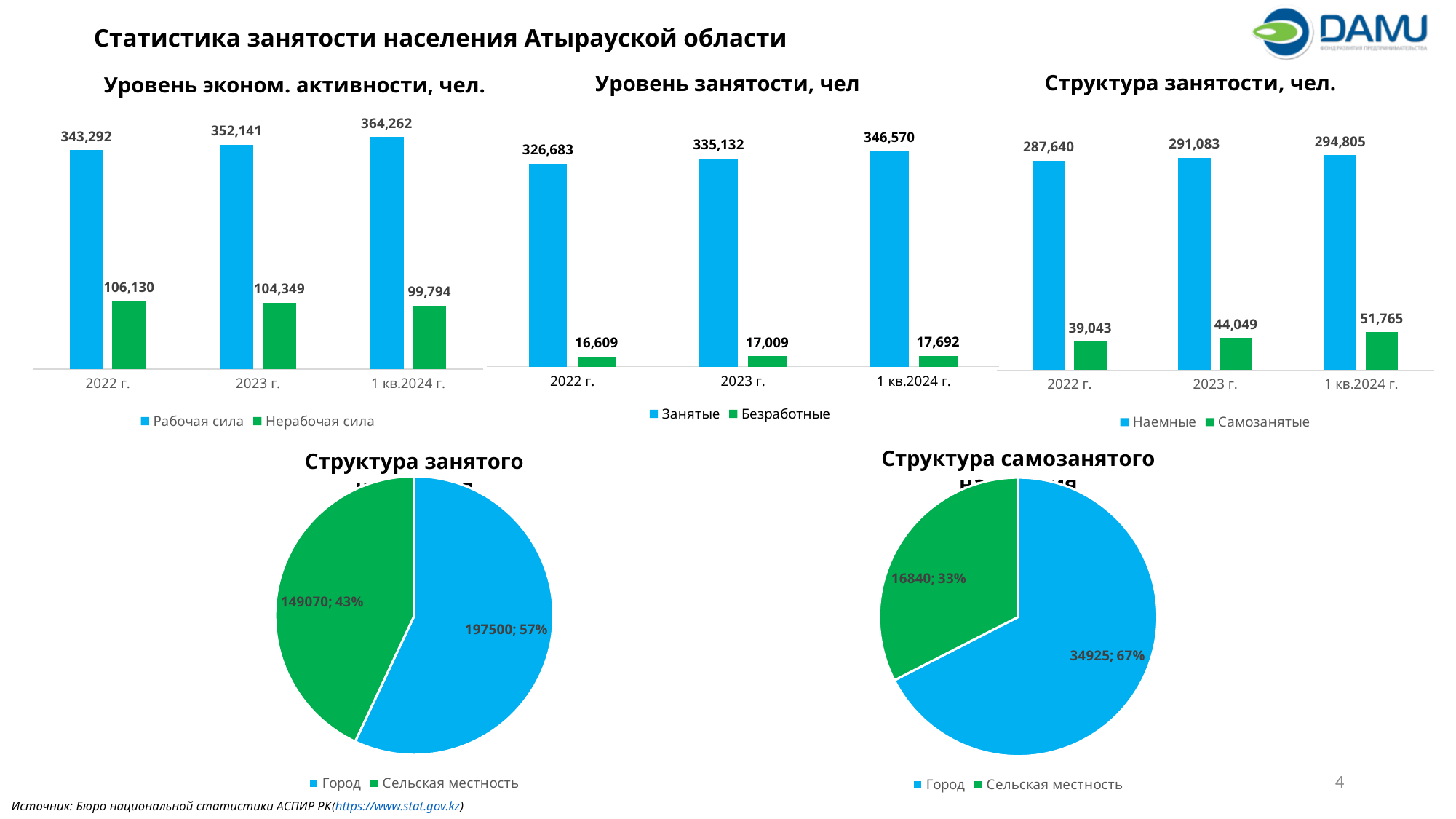
In the chart 'Уровень занятости, чел', how many series does the legend list? 2 What type of chart is the bottom-right chart ('Структура самозанятого населения')? pie chart In the bottom-right pie chart ('Структура самозанятого населения'), what is the value for Сельская местность? 16840 In the chart 'Структура занятости, чел.', how many periods are shown on the x axis? 3 In the chart 'Уровень эконом. активности, чел.', in which period is Нерабочая сила lowest? 1 кв.2024 г. In the chart 'Структура занятости, чел.', in which period is Наемные highest? 1 кв.2024 г. In the chart 'Уровень занятости, чел', what is the value of Безработные for 2022 г.? 16,609 In the bottom-left pie chart ('Структура занятого населения'), what share does Город have? 57% In the chart 'Структура занятости, чел.', what is the value of Самозанятые for 1 кв.2024 г.? 51,765 In the chart 'Уровень занятости, чел', what is the difference between Занятые in 1 кв.2024 г. and in 2023 г.? 11,438 In the chart 'Уровень эконом. активности, чел.', what is the value of Рабочая сила for 2023 г.? 352,141 In the chart 'Уровень эконом. активности, чел.', does Рабочая сила rise or fall from 2022 г. to 1 кв.2024 г.? rise